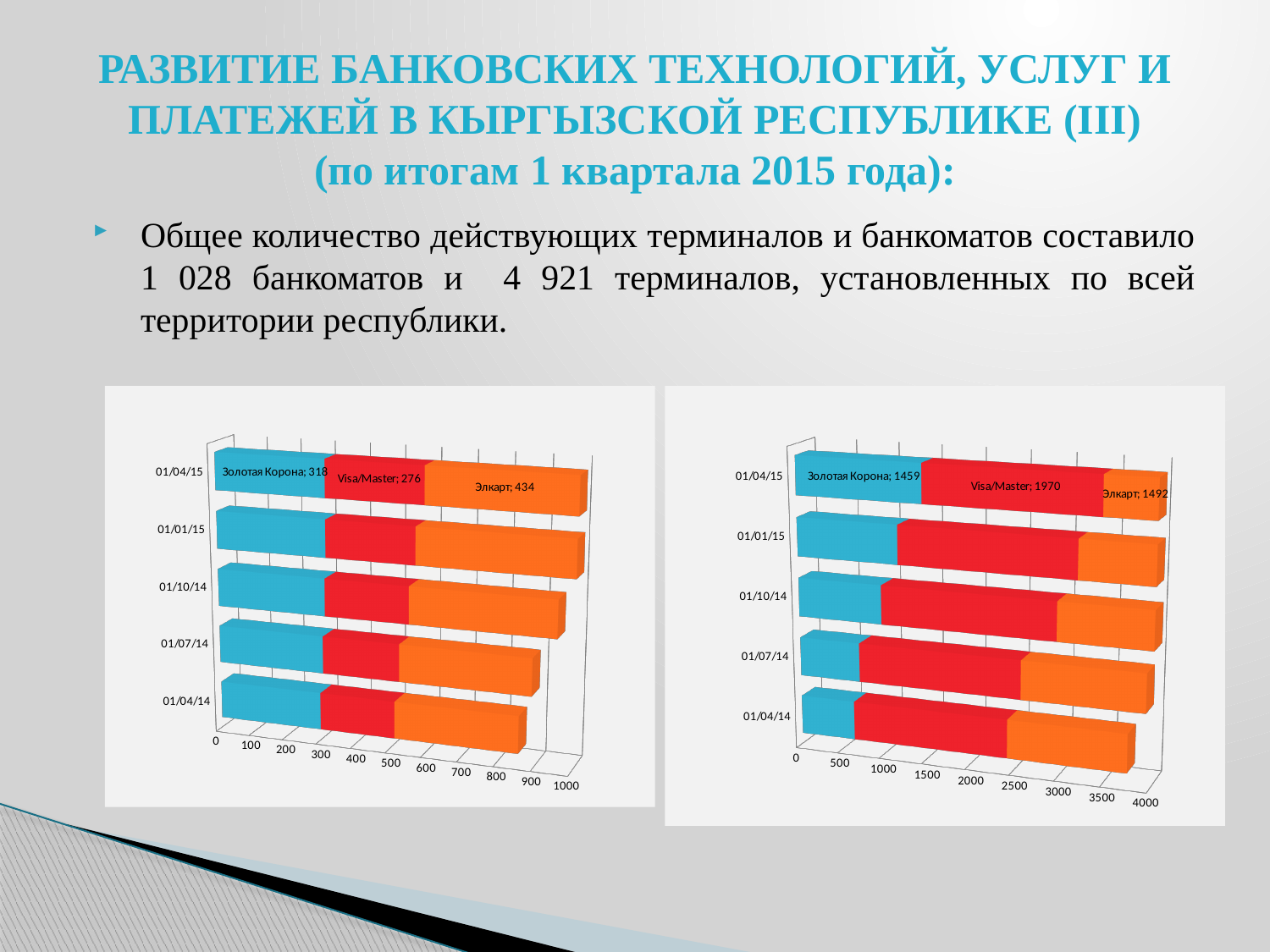
In the right chart, what is the total of the stacked bar for 01/04/15? 4921 In the left chart, what is the value for Золотая Корона on 01/04/15? 318 How many date categories are shown in the left chart? 5 In the left chart, which series has the highest value on 01/04/15? Элкарт In the left chart, what is the difference between Элкарт and Visa/Master on 01/04/15? 158 In the left chart, what is the total of the stacked bar for 01/04/15? 1028 In the left chart, what is the value for Элкарт on 01/04/15? 434 In the right chart, what is the value for Visa/Master on 01/04/15? 1970 In the right chart, what is the value for Элкарт on 01/04/15? 1492 In the right chart, what is the difference between Visa/Master and Золотая Корона on 01/04/15? 511 In the right chart, which series has the lowest value on 01/04/15? Золотая Корона What kind of chart is the right chart? Stacked bar chart